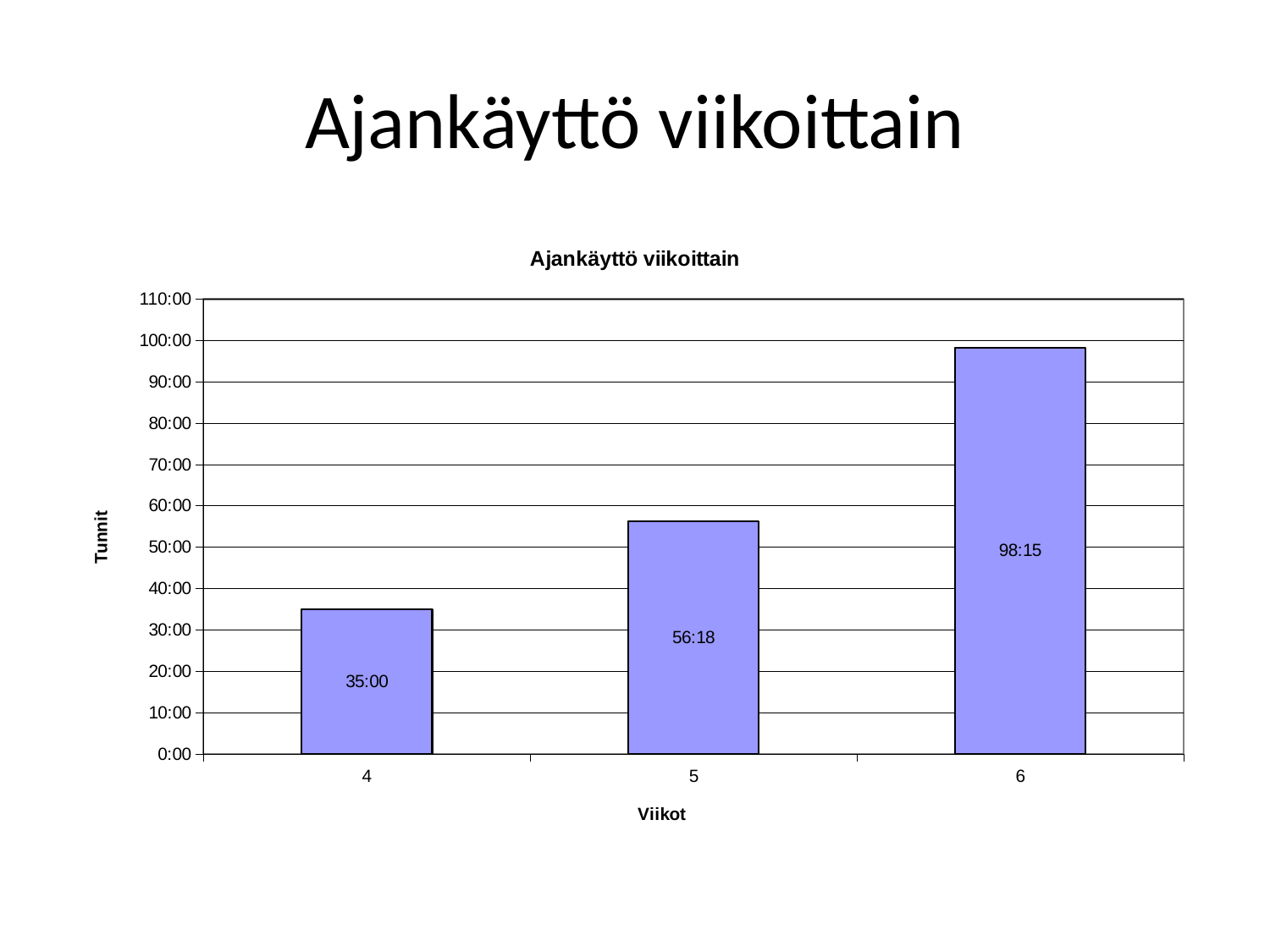
What kind of chart is shown on the slide? bar chart Is the value for week 6 greater or less than 90:00? greater Do the values rise or fall from week 4 to week 6? rise Which week has the lowest value? 4 Which week has the highest value? 6 What is the difference between the values for week 5 and week 4? 21:18 What is the value for week 5? 56:18 How many weeks are shown on the x axis? 3 What is the difference between the values for week 6 and week 5? 41:57 What is the value for week 6? 98:15 Which is larger, the value for week 4 or the value for week 5? week 5 What is the value for week 4? 35:00